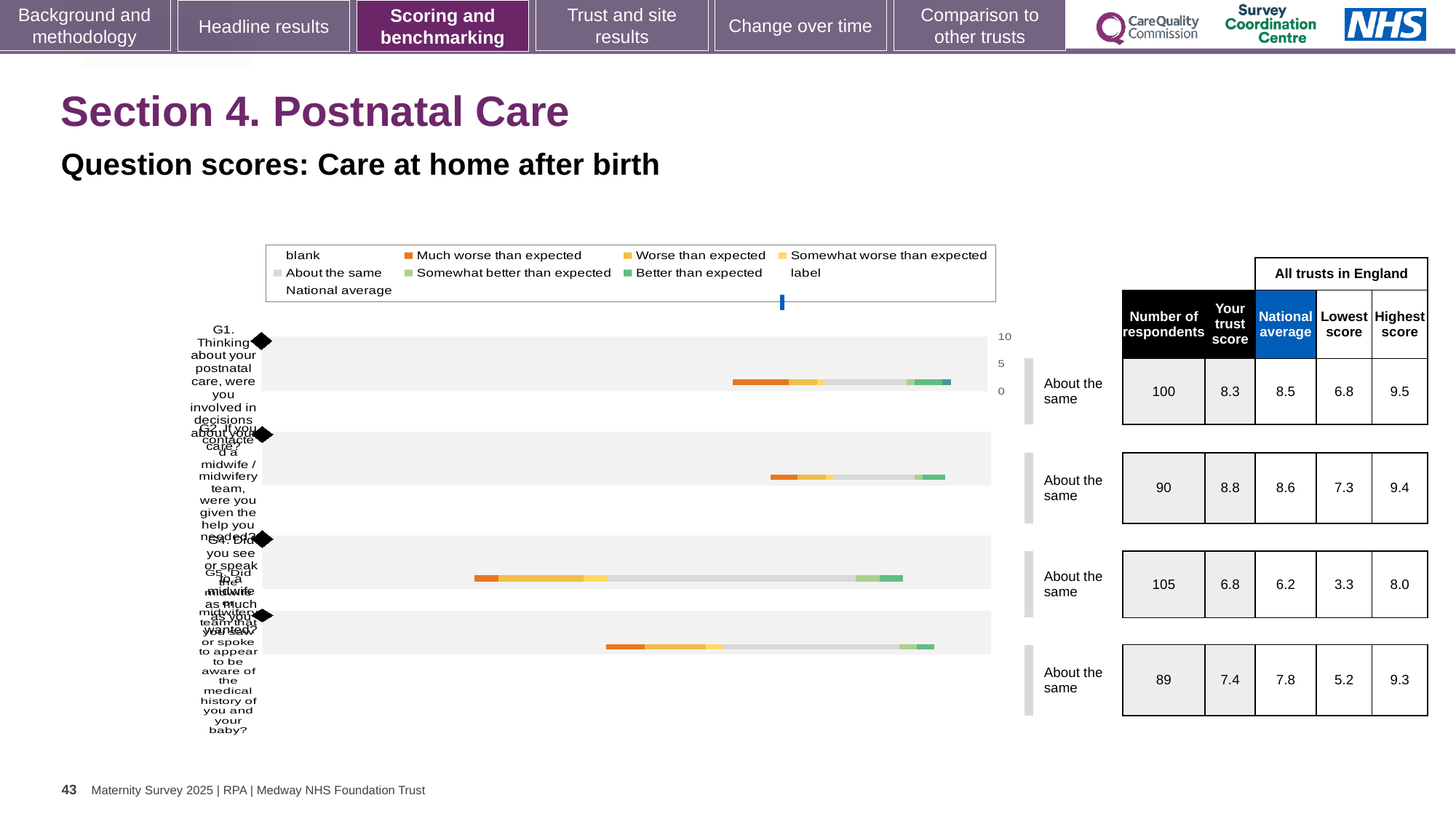
For the first row (G1), which is larger: the trust score or the national average? the national average (8.5) What benchmark category is shown next to each of the four bars? About the same What kind of chart is shown on the slide? bar chart Which row has the highest number of respondents? the third row (105) What is the subtitle of the chart on this slide? Question scores: Care at home after birth What is the number of respondents for the first row (G1, involved in decisions about your postnatal care)? 100 What is the trust score for the second row (G2, given the help you needed when contacting a midwife)? 8.8 For the first row (G1), what is the difference between the highest score and the lowest score? 2.7 What is the national average for the third row of the table? 6.2 How many question rows (bars) are plotted in the chart? 4 For the fourth row, what is the difference between the national average and the trust score? 0.4 Which row has the lowest 'Lowest score' value in the table? the third row (3.3)